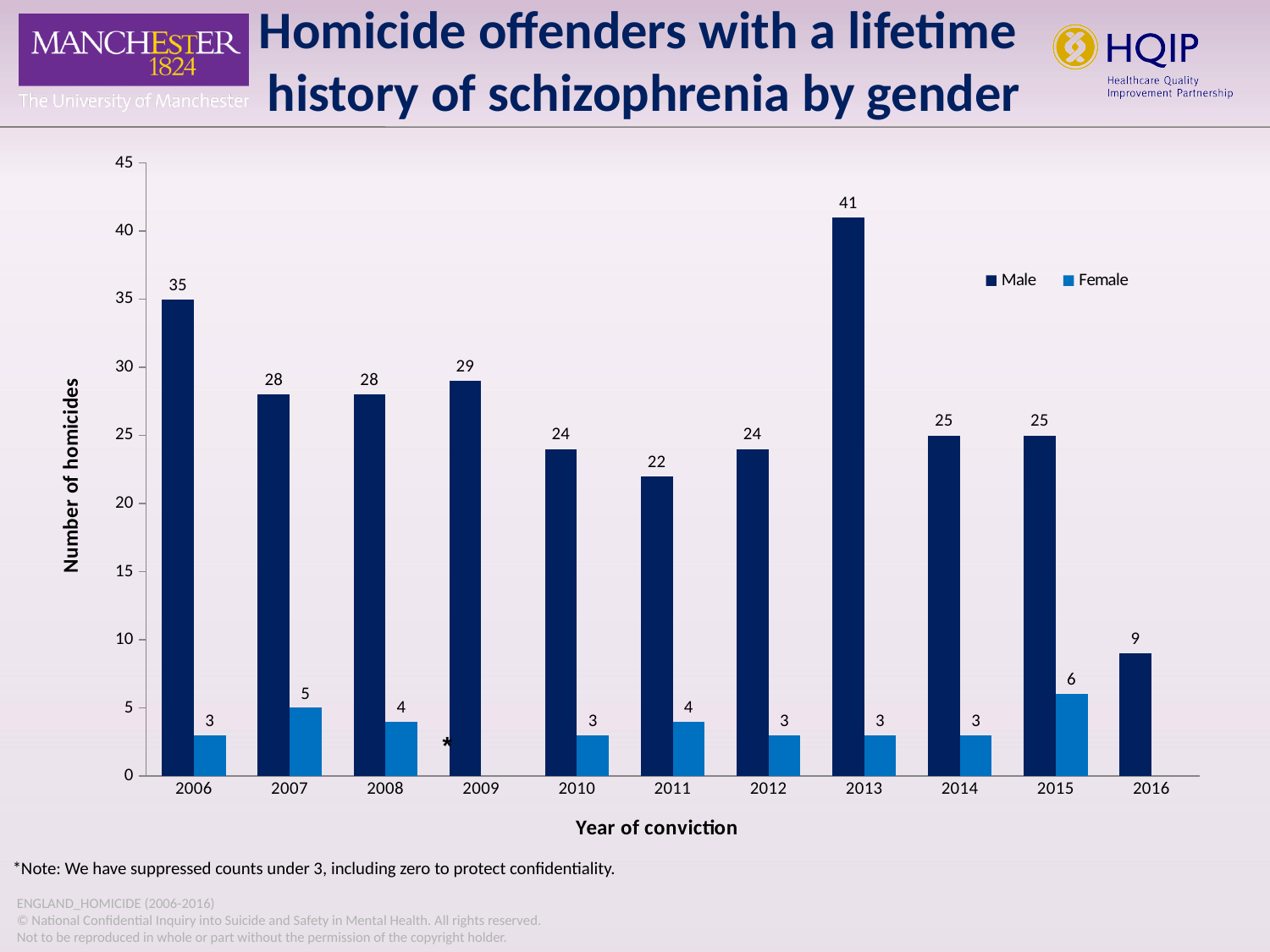
Which year has the highest Male value? 2013 How many series does the legend list? 2 What is the Male value for 2013? 41 Which is larger, the Female value for 2007 or the Female value for 2008? 2007 What is the Female value for 2015? 6 What is the Male value for 2011? 22 What kind of chart is shown on the slide? Bar chart What is the label of the y axis? Number of homicides How many years are shown on the x axis? 11 What is the difference between the Male values for 2013 and 2006? 6 Which year has the lowest Male value? 2016 What is the difference between the Male and Female values for 2015? 19